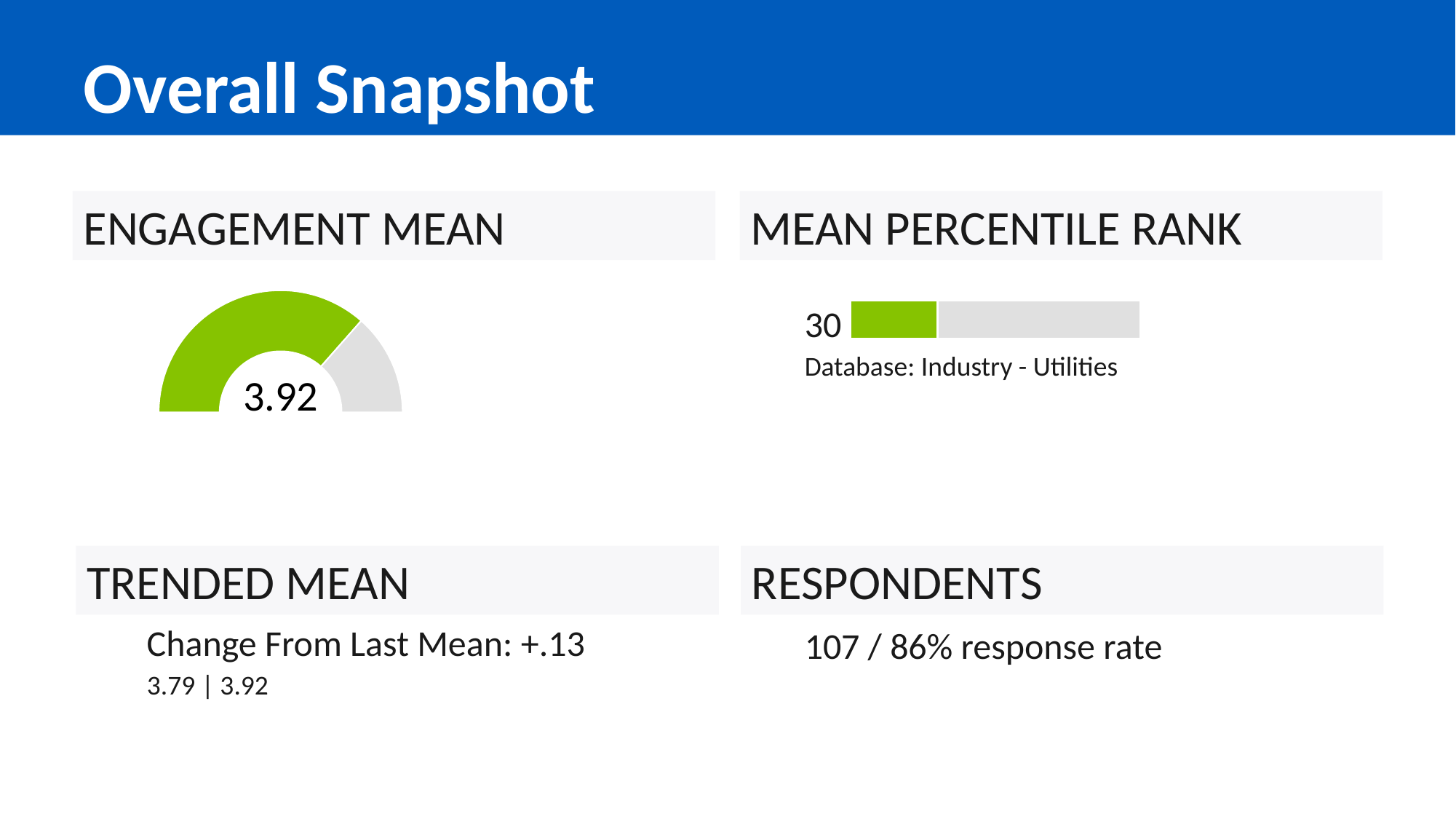
In the Mean Percentile Rank chart, is the green filled portion of the bar greater or less than half of the bar? less In the Mean Percentile Rank chart, what value is shown next to the bar? 30 Under Trended Mean, did the mean rise or fall from the previous value to the current value? rise Under Trended Mean, what is the change from the last mean? +.13 What colour is the filled portion of the Engagement Mean gauge? green Under Respondents, how many respondents are reported? 107 What kind of chart is shown under the Mean Percentile Rank heading? bar chart Which database is the Mean Percentile Rank chart compared against? Industry - Utilities In the Engagement Mean gauge, is the green filled portion greater or less than half of the gauge? greater In the Engagement Mean chart, what value is displayed in the centre of the gauge? 3.92 What kind of chart is shown under the Engagement Mean heading? gauge chart Under Trended Mean, what was the previous mean value? 3.79